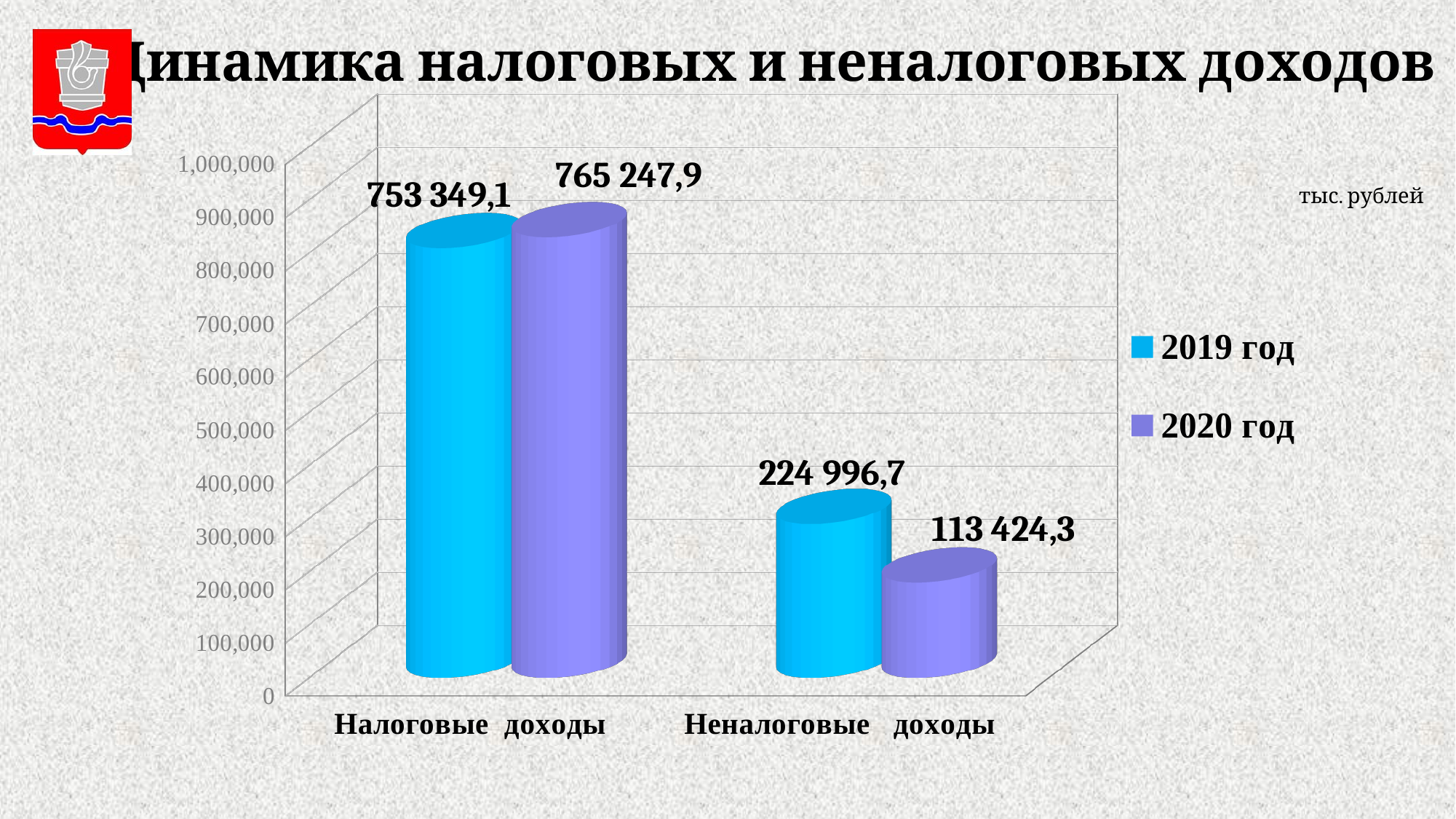
What unit of measurement is indicated on the chart? тыс. рублей What is the value for Неналоговые доходы in 2019 год? 224 996,7 For Неналоговые доходы, which year has the larger value, 2019 год or 2020 год? 2019 год What is the value for Налоговые доходы in 2020 год? 765 247,9 What is the value for Налоговые доходы in 2019 год? 753 349,1 How many series does the legend list? 2 Which bar has the highest value on the chart? Налоговые доходы, 2020 год What is the value for Неналоговые доходы in 2020 год? 113 424,3 Which bar has the lowest value on the chart? Неналоговые доходы, 2020 год What is the difference between the 2019 год and 2020 год values for Неналоговые доходы? 111 572,4 What is the difference between the 2020 год and 2019 год values for Налоговые доходы? 11 898,8 How many categories are shown on the x axis? 2